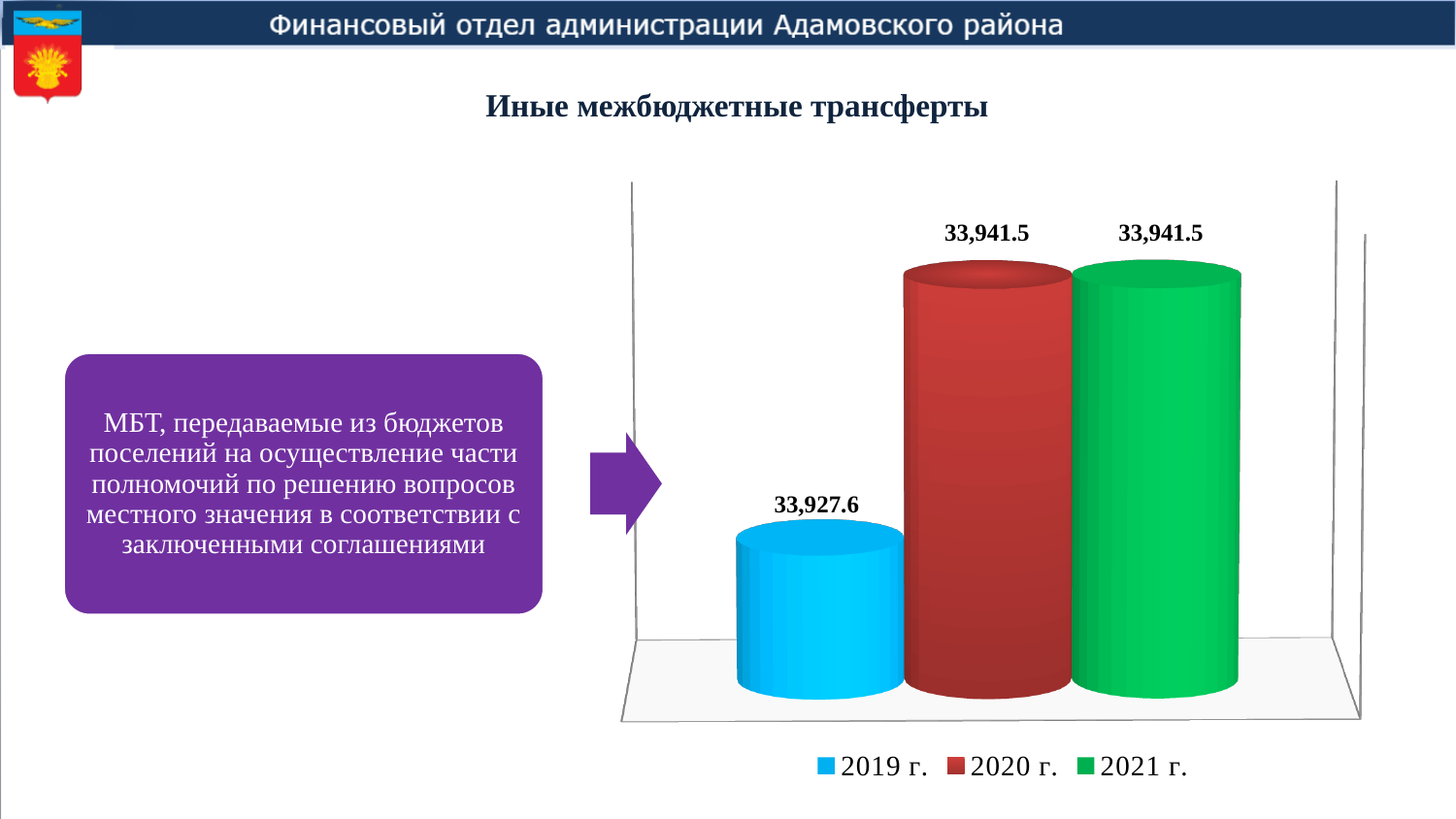
Which year has the lowest value? 2019 г. What is the value for 2021 г.? 33,941.5 Are the values for 2020 г. and 2021 г. equal? Yes Which is larger, the value for 2019 г. or the value for 2020 г.? 2020 г. What is the value for 2019 г.? 33,927.6 Does the value rise or fall from 2019 г. to 2020 г.? Rise What is the title of the chart on the slide? Иные межбюджетные трансферты How many entries does the legend list? 3 What is the value for 2020 г.? 33,941.5 What kind of chart is shown on the slide? Bar chart What is the difference between the values for 2020 г. and 2019 г.? 13.9 How many bars are plotted in the chart? 3